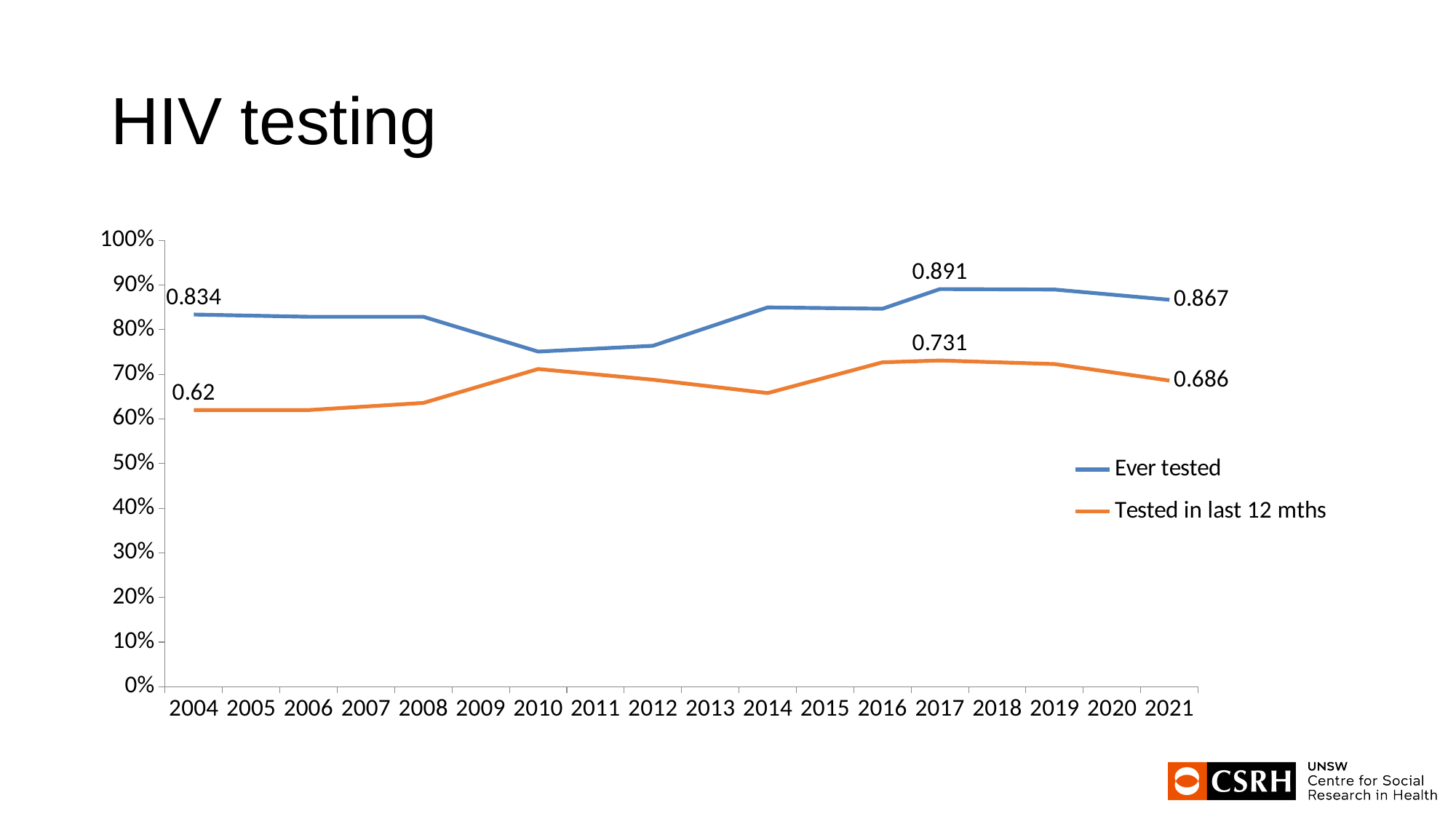
What is the difference between the Ever tested values in 2017 and 2021? 0.024 What is the value for Tested in last 12 mths in 2021? 0.686 In 2021, which series has the larger value, Ever tested or Tested in last 12 mths? Ever tested What is the value for Tested in last 12 mths in 2017? 0.731 What is the value for Ever tested in 2004? 0.834 What is the value for Ever tested in 2021? 0.867 In 2017, what is the difference between Ever tested and Tested in last 12 mths? 0.16 Is the value for Ever tested in 2010 greater or less than 80%? less How many series does the legend list? 2 What is the value for Ever tested in 2017? 0.891 What kind of chart is shown on the slide? line chart What is the value for Tested in last 12 mths in 2004? 0.62